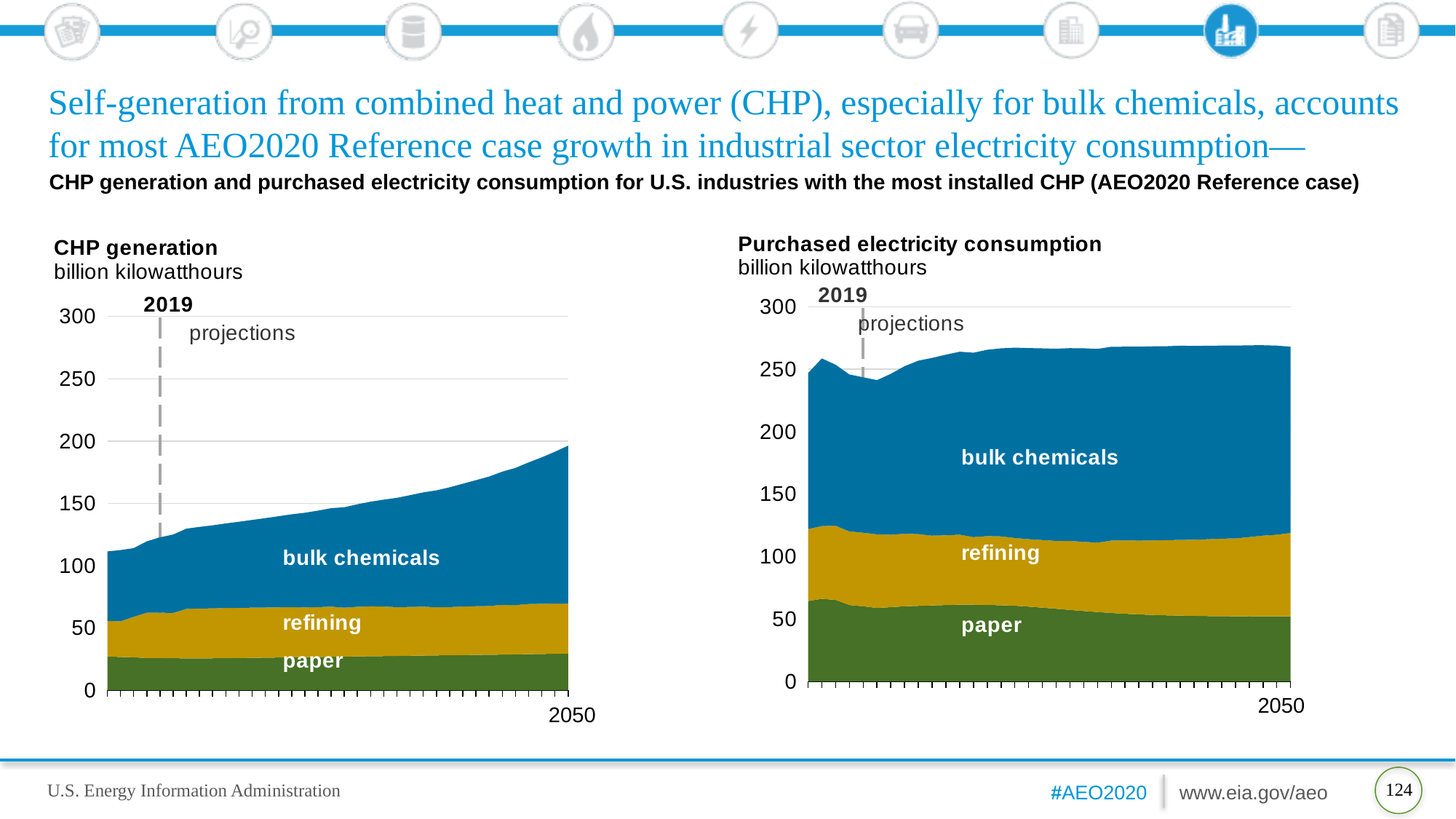
What kind of chart is the CHP generation chart? stacked area chart In the CHP generation chart, which series is the smallest? paper What year does the dashed vertical line mark in both charts? 2019 In the Purchased electricity consumption chart, which series is the largest? bulk chemicals What unit is used on the y axis of both charts? billion kilowatthours In the CHP generation chart, does the total rise or fall from 2019 to 2050? rises In the CHP generation chart, is the total value in 2050 greater or less than 200? less In the CHP generation chart, is the total value in 2019 greater or less than 150? less How many series are shown in the Purchased electricity consumption chart? 3 In the Purchased electricity consumption chart, is the paper value at the start of the series greater or less than 50? greater In the CHP generation chart, which series is the largest? bulk chemicals